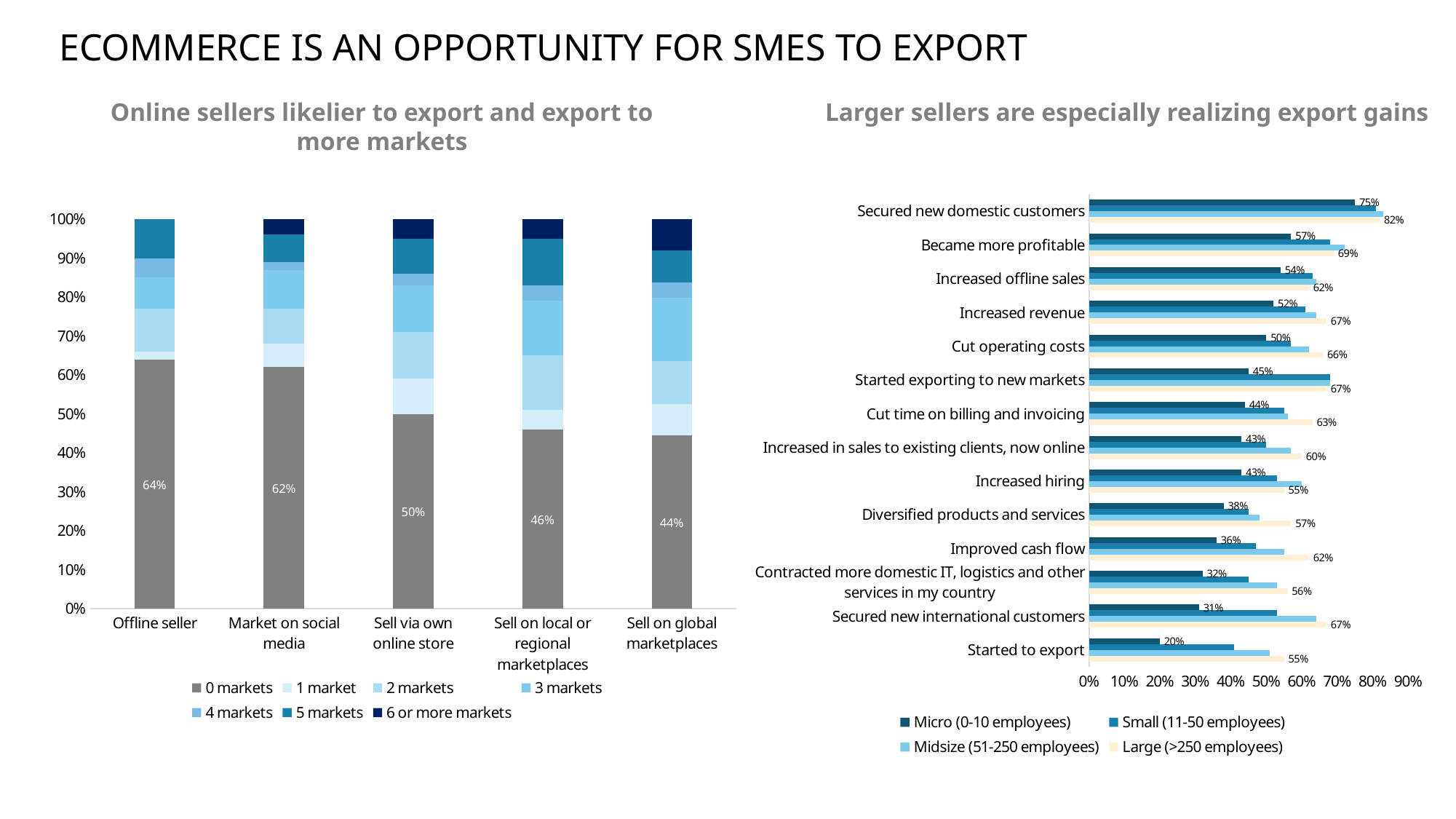
In the chart titled "Online sellers likelier to export and export to more markets", what is the difference between the 0 markets share for Offline seller and for Sell via own online store? 14% In the chart titled "Online sellers likelier to export and export to more markets", which category has the lowest share for 0 markets? Sell on global marketplaces In the chart titled "Online sellers likelier to export and export to more markets", what is the value for 0 markets for Sell on global marketplaces? 44% In the chart titled "Larger sellers are especially realizing export gains", which category has the highest value for Micro (0-10 employees)? Secured new domestic customers What kind of chart is the one titled "Larger sellers are especially realizing export gains"? Bar chart In the chart titled "Larger sellers are especially realizing export gains", what is the difference between the Large (>250 employees) and Micro (0-10 employees) values for Secured new international customers? 36% In the chart titled "Larger sellers are especially realizing export gains", what is the value for Micro (0-10 employees) for Started to export? 20% In the chart titled "Larger sellers are especially realizing export gains", what is the value for Large (>250 employees) for Secured new domestic customers? 82% In the chart titled "Online sellers likelier to export and export to more markets", what is the value for 0 markets for Offline seller? 64% In the chart titled "Larger sellers are especially realizing export gains", is the Micro (0-10 employees) value for Improved cash flow greater or less than the Large (>250 employees) value? less In the chart titled "Online sellers likelier to export and export to more markets", how many categories are shown on the x axis? 5 In the chart titled "Online sellers likelier to export and export to more markets", how many series does the legend list? 7